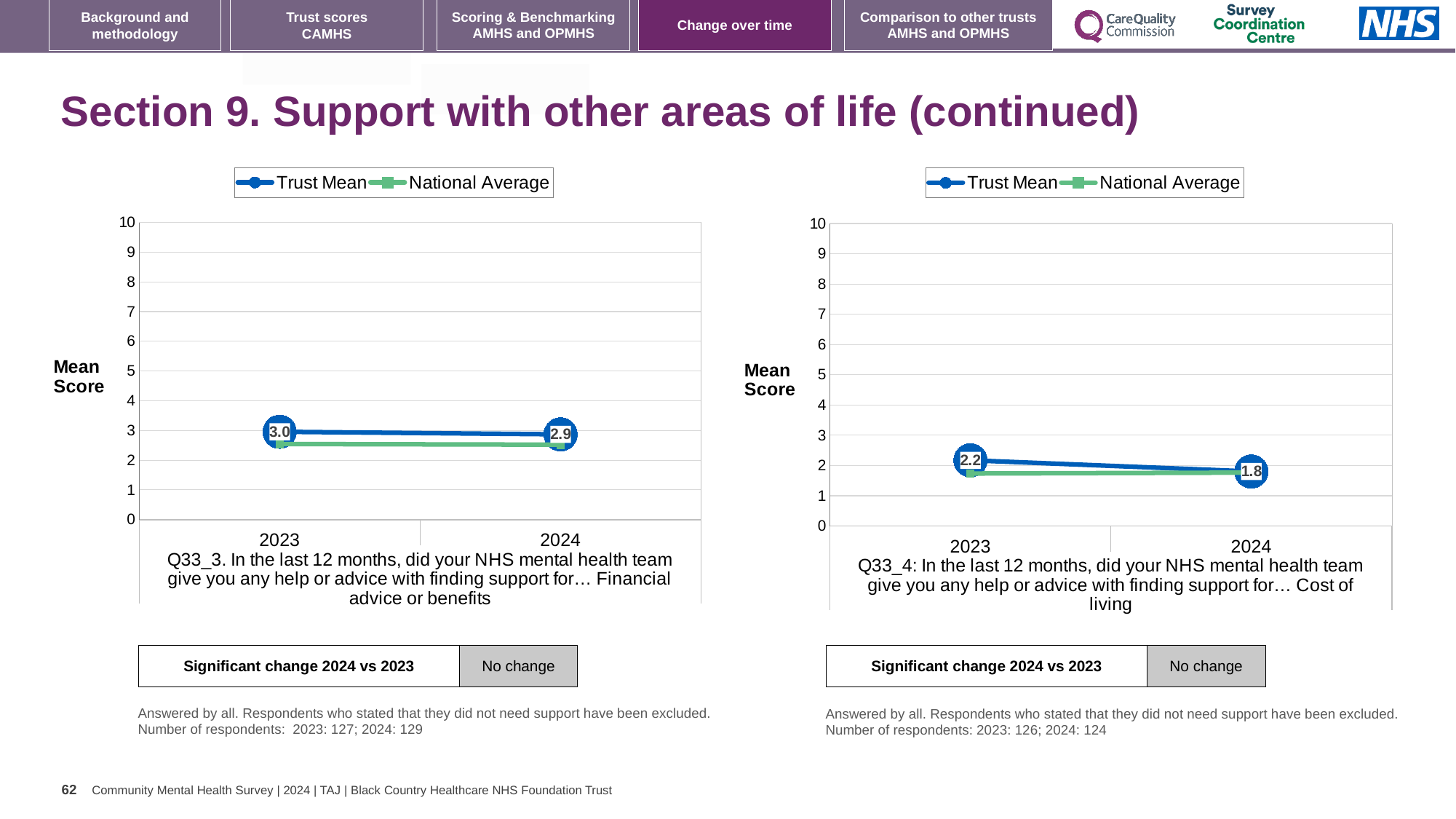
What type of chart is the left chart (Q33_3, Financial advice or benefits)? line chart In the right chart (Q33_4, Cost of living), by how much did the Trust Mean change from 2023 to 2024? 0.4 How many years are plotted on the x axis of the left chart (Q33_3, Financial advice or benefits)? 2 In the left chart (Q33_3, Financial advice or benefits), what is the Trust Mean for 2024? 2.9 In the left chart (Q33_3, Financial advice or benefits), is the National Average for 2023 greater or less than 3? less In the right chart (Q33_4, Cost of living), which is higher in 2023, the Trust Mean or the National Average? Trust Mean In the right chart (Q33_4, Cost of living), what is the Trust Mean for 2024? 1.8 In the left chart (Q33_3, Financial advice or benefits), what is the Trust Mean for 2023? 3.0 How many series does the legend of the right chart (Q33_4, Cost of living) list? 2 In the right chart (Q33_4, Cost of living), does the Trust Mean rise or fall from 2023 to 2024? fall In the left chart (Q33_3, Financial advice or benefits), what is the difference between the Trust Mean in 2023 and 2024? 0.1 In the right chart (Q33_4, Cost of living), what is the Trust Mean for 2023? 2.2